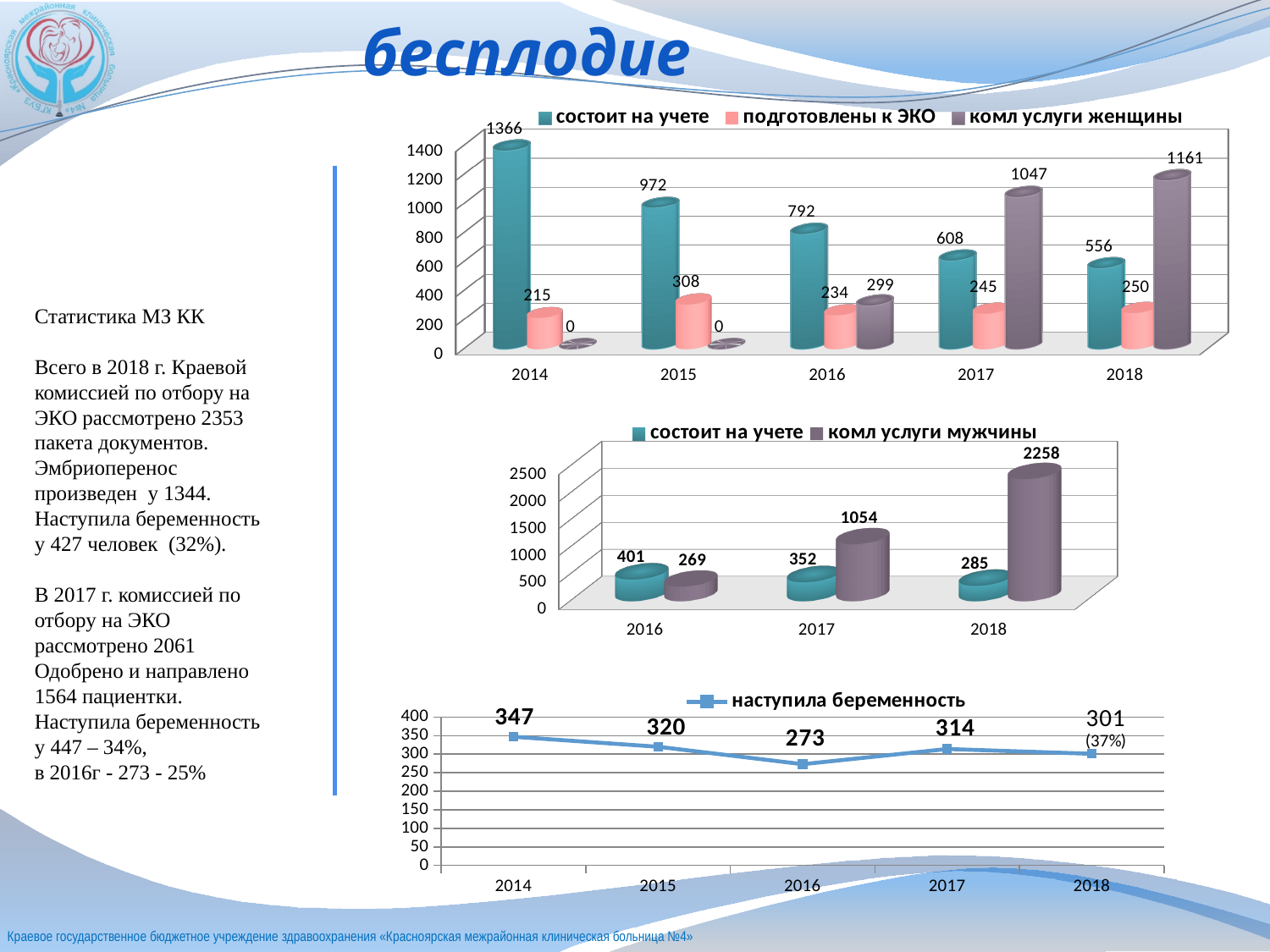
In the top chart, what is the value for 'комл услуги женщины' in 2018? 1161 In the top chart, does the value for 'состоит на учете' rise or fall from 2014 to 2018? fall In the middle chart, how many years are shown on the x axis? 3 In the bottom chart, which year has the highest value for 'наступила беременность'? 2014 In the middle chart, which is larger in 2017: 'состоит на учете' or 'комл услуги мужчины'? комл услуги мужчины In the top chart, how many series does the legend list? 3 In the top chart, what is the value for 'состоит на учете' in 2014? 1366 In the bottom chart, what is the value for 'наступила беременность' in 2016? 273 In the middle chart, what is the value for 'комл услуги мужчины' in 2018? 2258 In the top chart, which year has the lowest value for 'состоит на учете'? 2018 In the top chart, what is the difference between 'состоит на учете' in 2014 and in 2015? 394 What kind of chart is the bottom chart? line chart